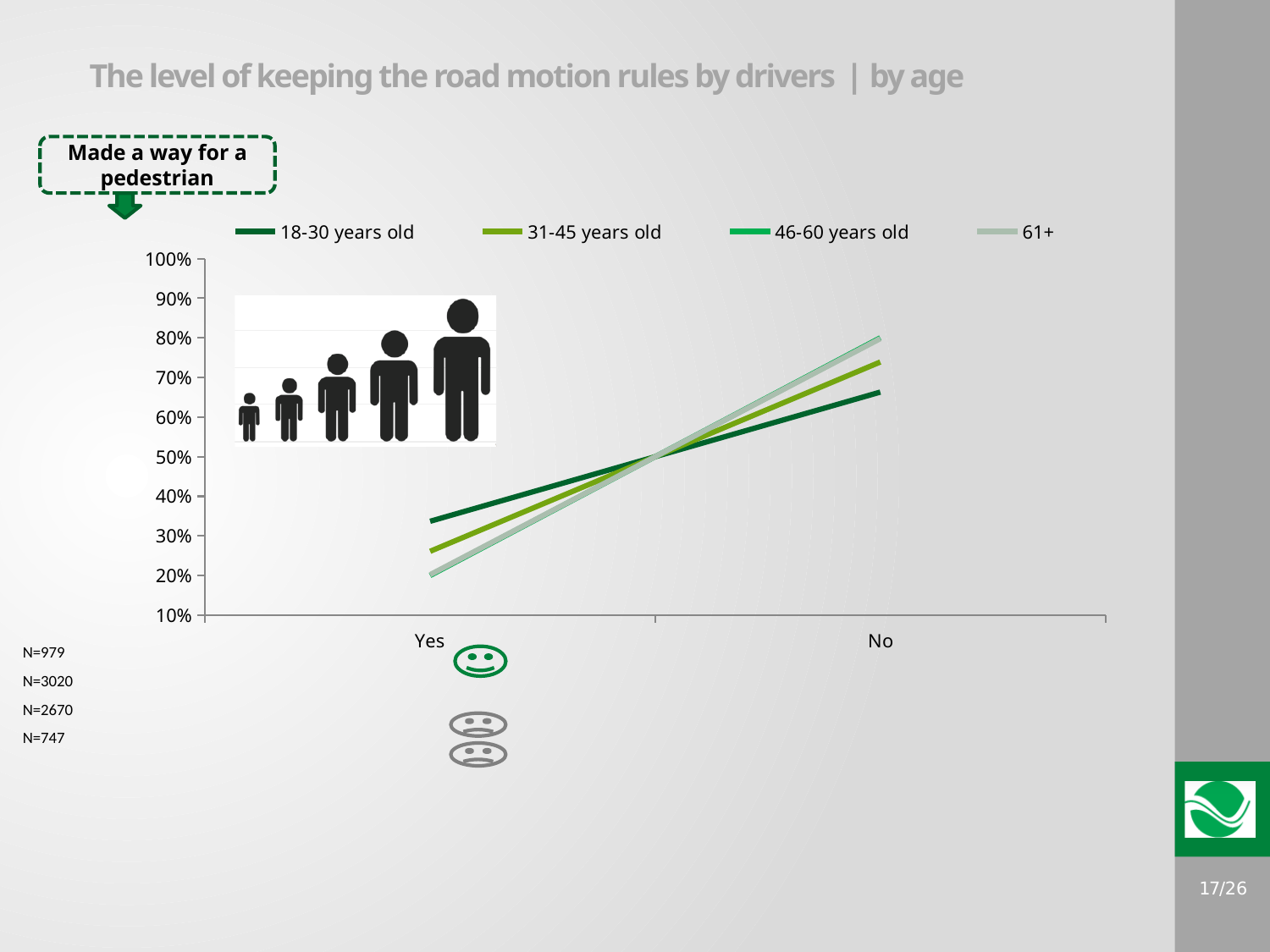
At Yes, which is larger: the value for 18-30 years old or the value for 61+? 18-30 years old How many series does the legend list? 4 At No, which is larger: the value for 61+ or the value for 18-30 years old? 61+ Does the line for 18-30 years old rise or fall from Yes to No? rises Is the value for 18-30 years old at No greater or less than 70%? less Which age group has the highest value at Yes? 18-30 years old What kind of chart is shown on the slide? line chart Is the value for 61+ at No greater or less than 70%? greater Is the value for 18-30 years old at Yes greater or less than 30%? greater How many categories are shown on the x axis? 2 What is the title of the slide? The level of keeping the road motion rules by drivers | by age